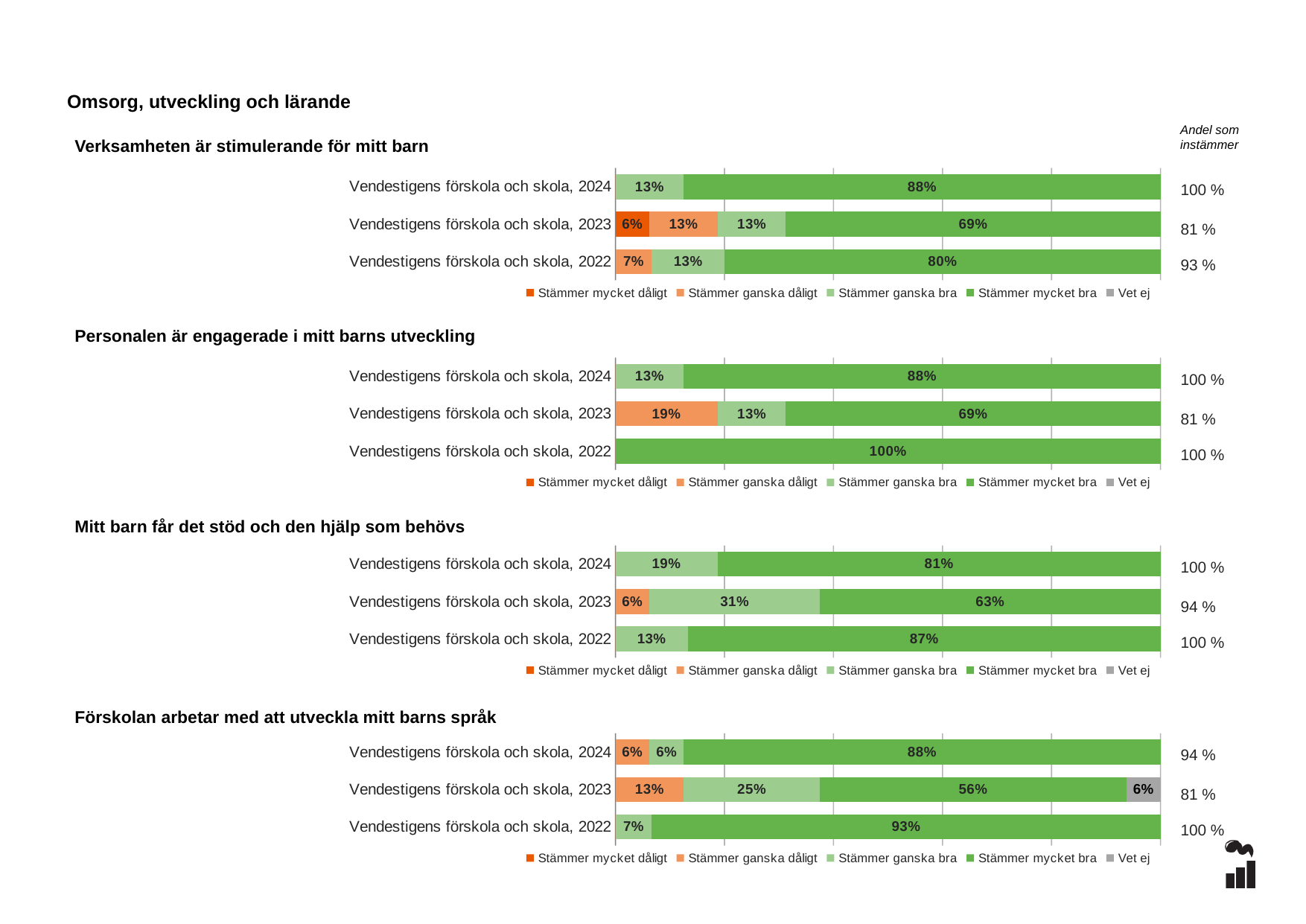
In the chart 'Förskolan arbetar med att utveckla mitt barns språk', what is the 'Andel som instämmer' value for Vendestigens förskola och skola, 2023? 81 % In the chart 'Verksamheten är stimulerande för mitt barn', what is the 'Stämmer mycket bra' value for Vendestigens förskola och skola, 2023? 69% In the chart 'Personalen är engagerade i mitt barns utveckling', what is the 'Stämmer mycket bra' value for Vendestigens förskola och skola, 2022? 100% What kind of chart is 'Personalen är engagerade i mitt barns utveckling'? Stacked bar chart In the chart 'Verksamheten är stimulerande för mitt barn', which year has the lowest 'Stämmer mycket bra' value? 2023 In the chart 'Förskolan arbetar med att utveckla mitt barns språk', which year has the highest 'Stämmer mycket bra' value? 2022 In the chart 'Verksamheten är stimulerande för mitt barn', what is the 'Stämmer mycket bra' value for Vendestigens förskola och skola, 2024? 88% In the chart 'Mitt barn får det stöd och den hjälp som behövs', what is the difference between the 'Stämmer mycket bra' values for 2022 and 2024? 6% How many series does the legend list for the chart 'Verksamheten är stimulerande för mitt barn'? 5 In the chart 'Förskolan arbetar med att utveckla mitt barns språk', what is the 'Vet ej' value for Vendestigens förskola och skola, 2023? 6% In the chart 'Mitt barn får det stöd och den hjälp som behövs', what is the 'Stämmer ganska bra' value for Vendestigens förskola och skola, 2023? 31% In the chart 'Personalen är engagerade i mitt barns utveckling', what is the 'Stämmer ganska dåligt' value for Vendestigens förskola och skola, 2023? 19%